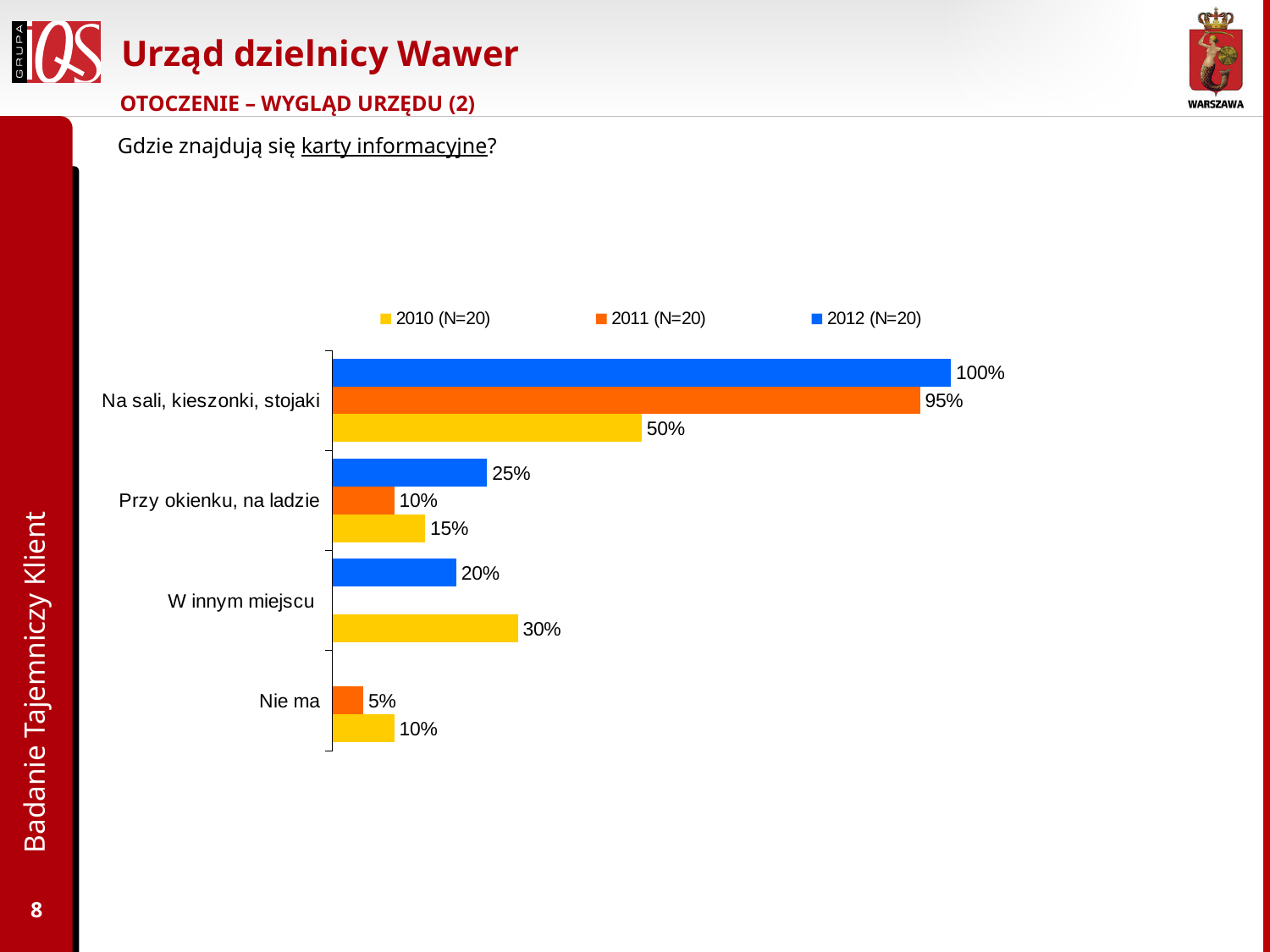
What is the value for 'Przy okienku, na ladzie' in the 2010 (N=20) series? 15% What is the value for 'Nie ma' in the 2011 (N=20) series? 5% Which series is shown in blue in the legend? 2012 (N=20) How many categories are shown on the chart? 4 What is the value for 'W innym miejscu' in the 2012 (N=20) series? 20% How many series does the legend list? 3 What kind of chart is shown on the slide? bar chart What is the difference between the 2012 (N=20) and 2010 (N=20) values for 'Na sali, kieszonki, stojaki'? 50% Which category has the highest value in the 2010 (N=20) series? Na sali, kieszonki, stojaki What is the value for 'Na sali, kieszonki, stojaki' in the 2011 (N=20) series? 95% For 'Przy okienku, na ladzie', which series has the larger value: 2012 (N=20) or 2011 (N=20)? 2012 (N=20) What is the value for 'Na sali, kieszonki, stojaki' in the 2012 (N=20) series? 100%